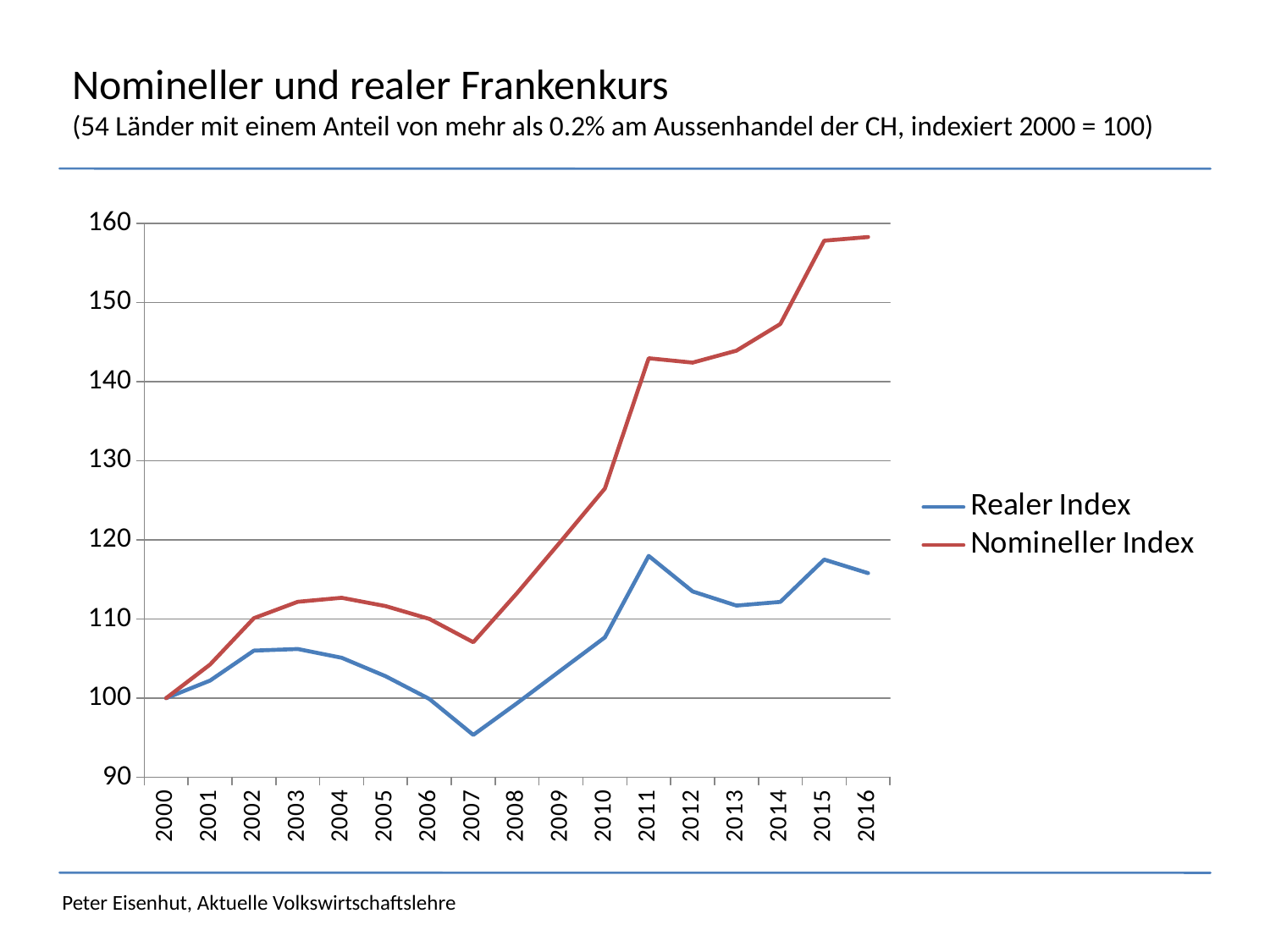
Does the Nomineller Index rise or fall between 2007 and 2015? rise Is the value of the Realer Index in 2016 greater or less than 110? greater Is the value of the Nomineller Index in 2015 greater or less than 150? greater How many years are plotted along the x axis? 17 What kind of chart is shown on the slide? line chart Which series has the higher value in 2016, Realer Index or Nomineller Index? Nomineller Index Is the value of the Realer Index in 2007 greater or less than 100? less In which year is the Nomineller Index at its lowest? 2000 How many series does the legend list? 2 In which year is the Realer Index at its lowest? 2007 What is the value of the Nomineller Index in 2000? 100